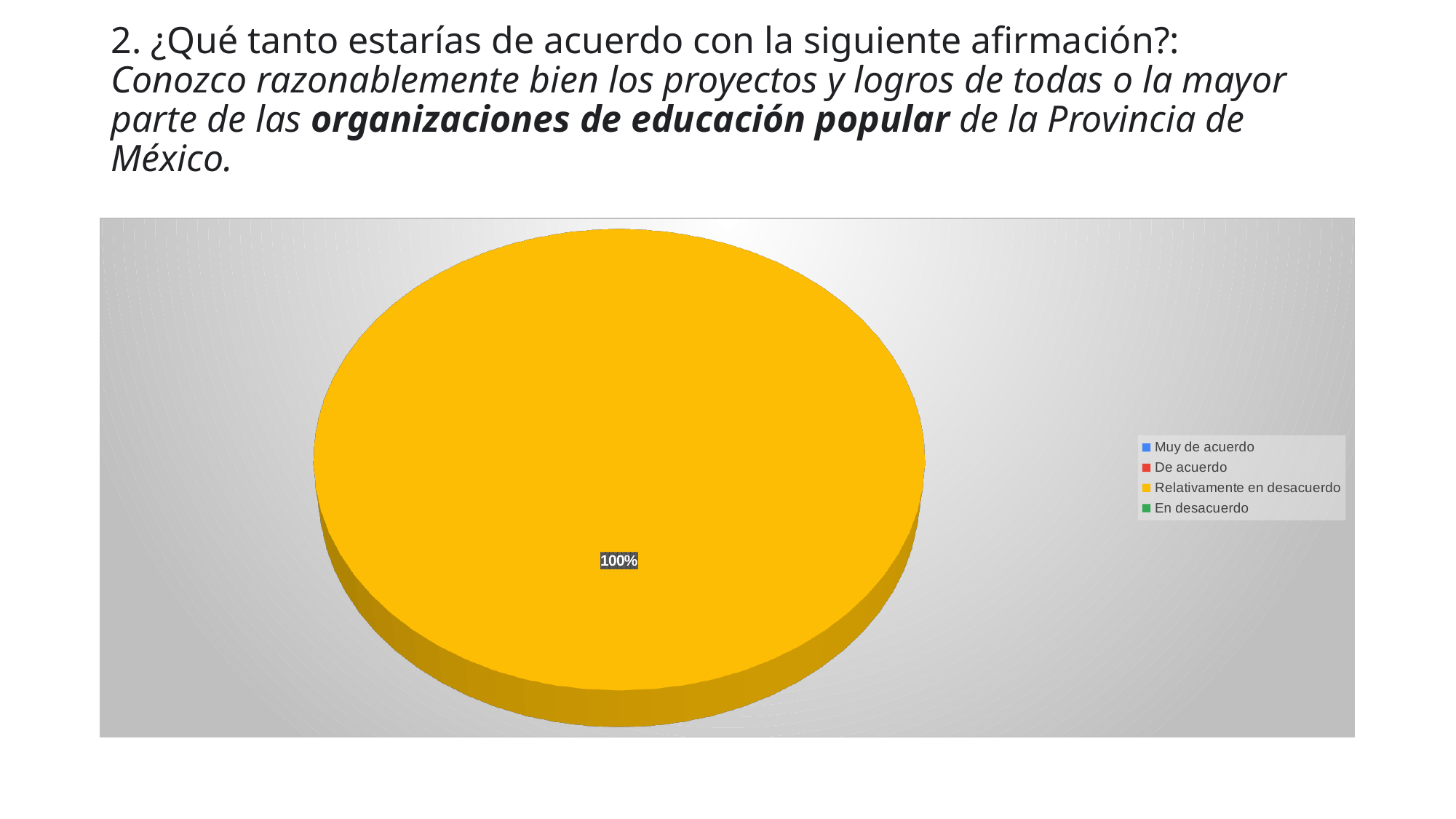
What share of the pie does "Relativamente en desacuerdo" take? 100% Which legend entry is shown in yellow? Relativamente en desacuerdo What kind of chart is shown on the slide? pie chart Is the share for "Relativamente en desacuerdo" greater or less than 50%? greater Which category makes up the entire pie? Relativamente en desacuerdo How many categories does the legend list? 4 Which legend entry is listed first? Muy de acuerdo What is the data label printed on the pie slice? 100% Which is larger, the share for "Relativamente en desacuerdo" or the share for "De acuerdo"? Relativamente en desacuerdo